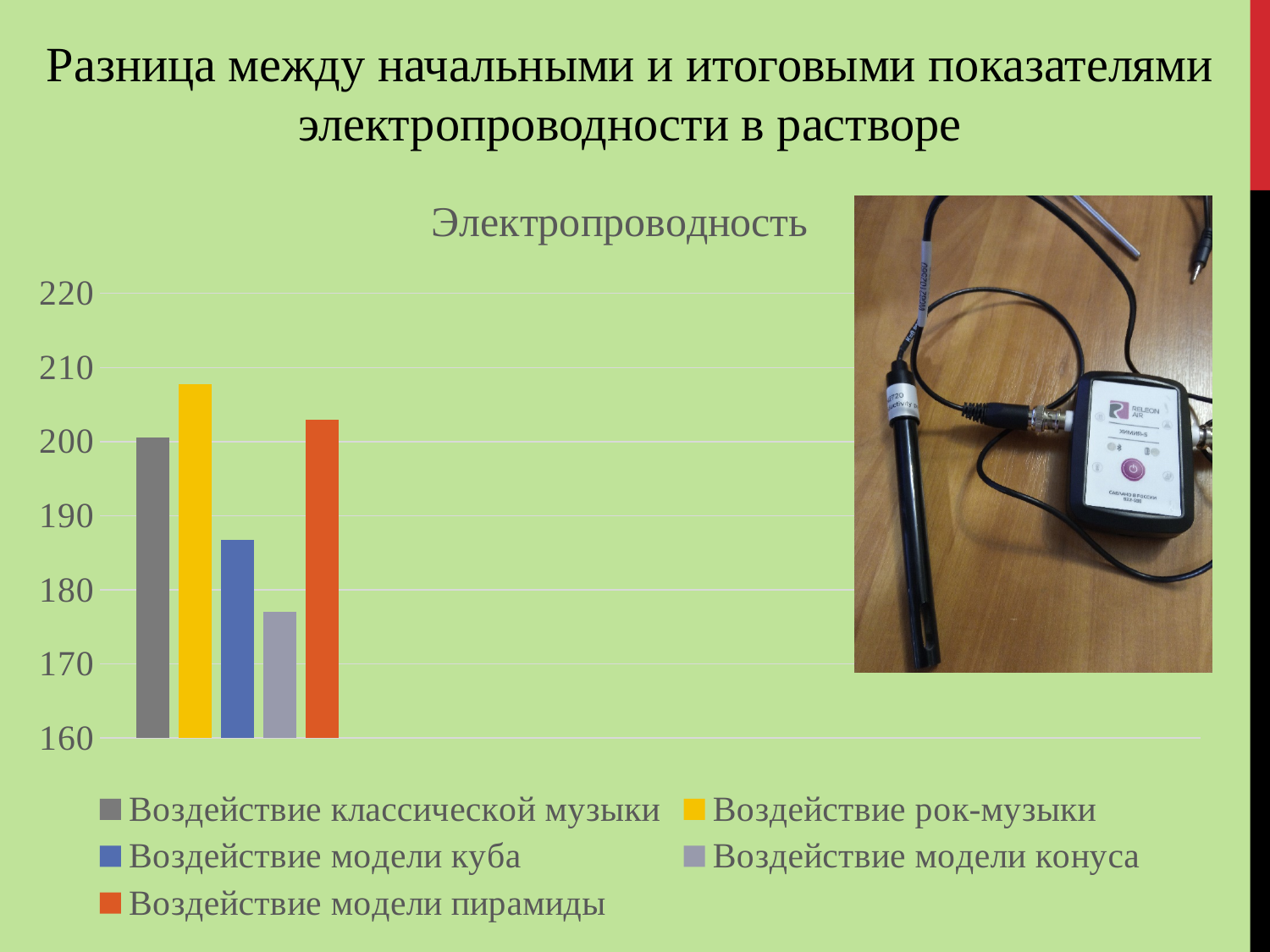
What colour is the bar for "Воздействие рок-музыки" in the chart? yellow Which is larger: the value for "Воздействие рок-музыки" or for "Воздействие модели куба"? Воздействие рок-музыки Which series has the highest value in the "Электропроводность" chart? Воздействие рок-музыки Which series has the lowest value in the "Электропроводность" chart? Воздействие модели конуса Is the value for "Воздействие модели пирамиды" greater or less than 210? less Is the value for "Воздействие классической музыки" greater or less than 190? greater Is the value for "Воздействие рок-музыки" greater or less than 200? greater Which is larger: the value for "Воздействие модели куба" or for "Воздействие модели конуса"? Воздействие модели куба How many series does the legend of the "Электропроводность" chart list? 5 What kind of chart is shown under the title "Электропроводность"? bar chart